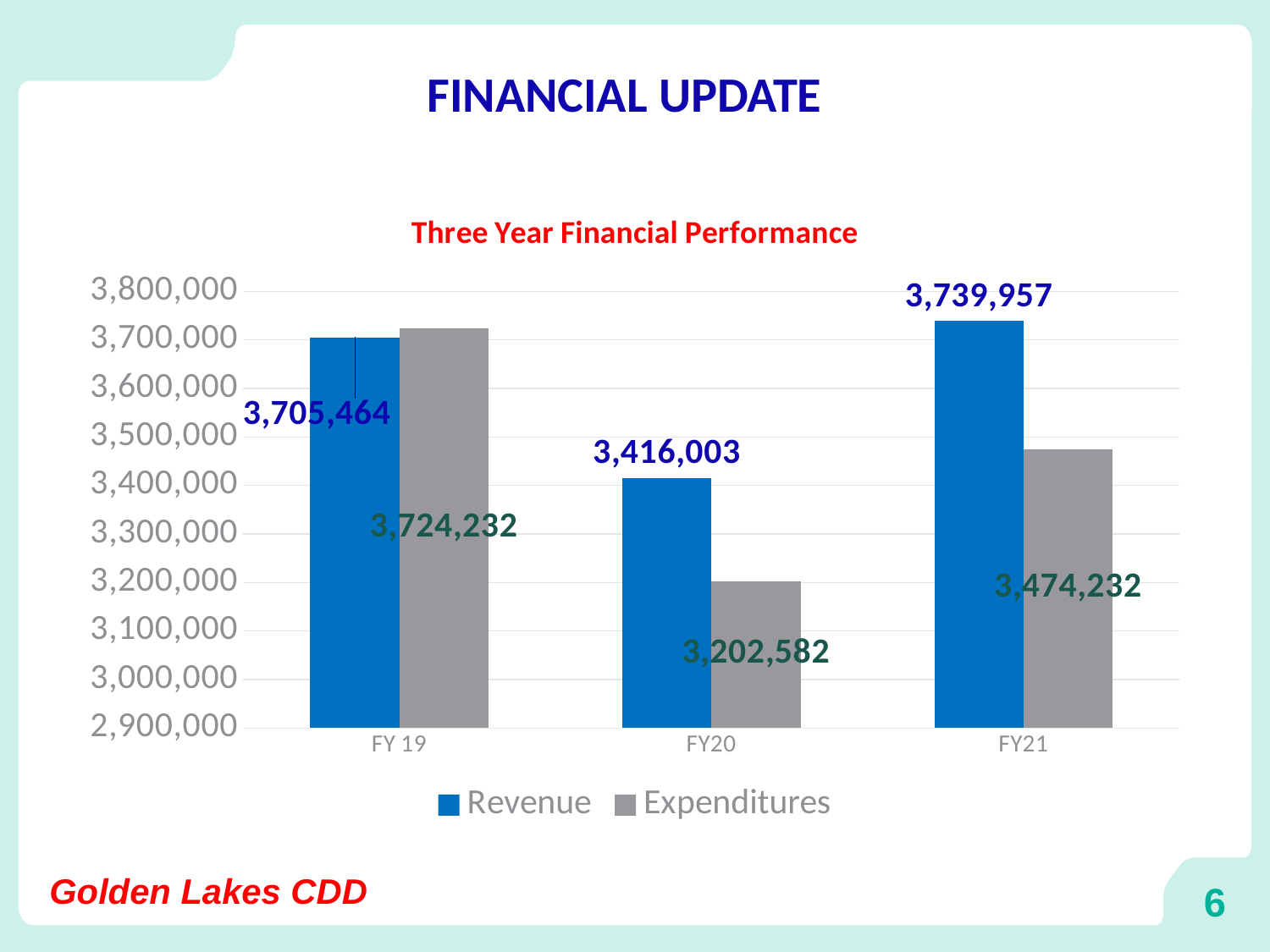
What kind of chart is shown on the slide? Bar chart In FY 19, which is larger, Revenue or Expenditures? Expenditures What is the difference between Revenue and Expenditures in FY21? 265,725 What is the difference between Revenue and Expenditures in FY20? 213,421 How many series does the legend list? 2 How many fiscal years are shown on the x axis? 3 What is the title of the chart? Three Year Financial Performance What is the Revenue value for FY 19? 3,705,464 What is the Expenditures value for FY20? 3,202,582 Which fiscal year has the lowest Expenditures? FY20 What is the Revenue value for FY21? 3,739,957 Which fiscal year has the highest Revenue? FY21